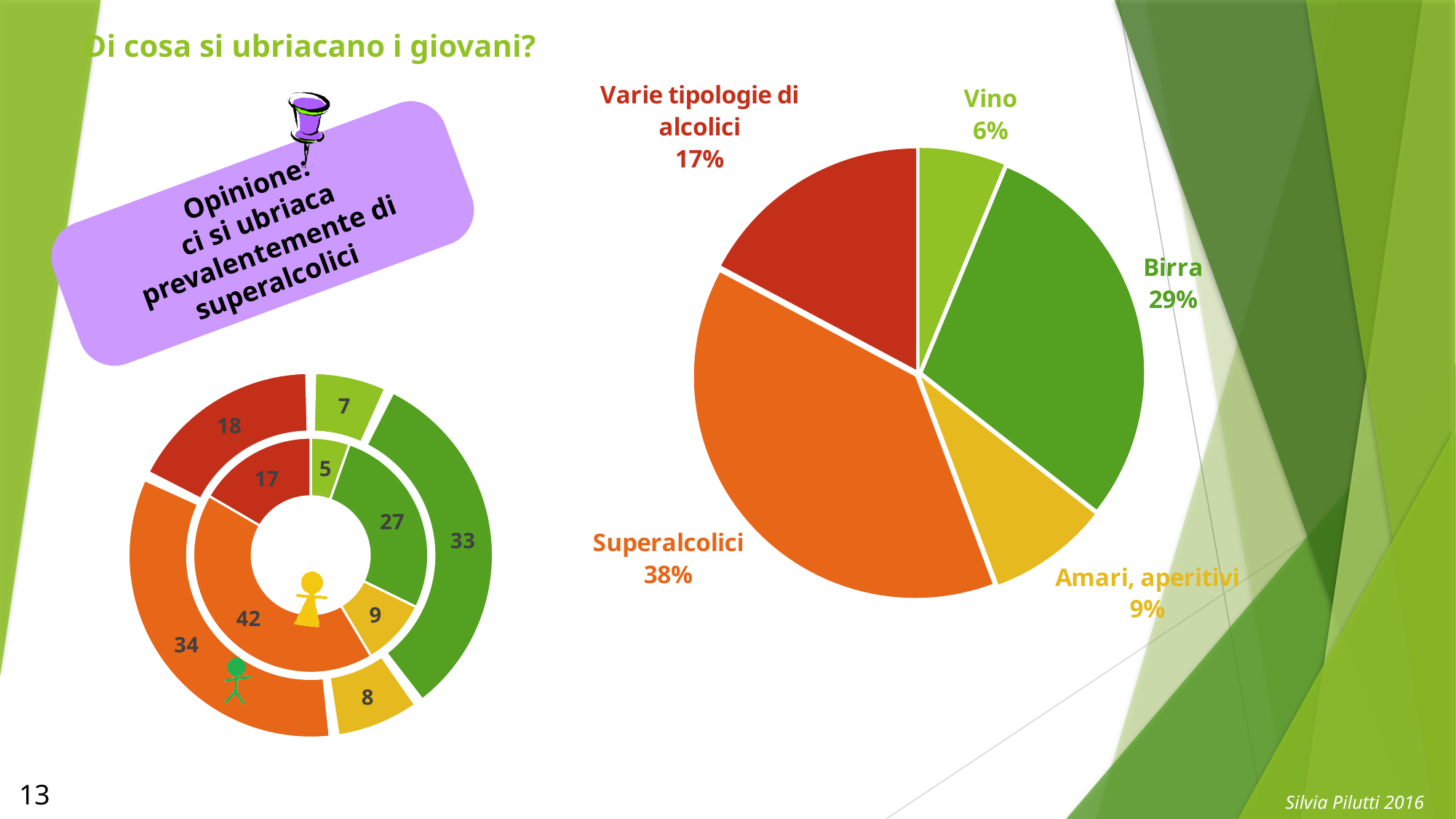
In the pie chart on the right, what share is shown for Superalcolici? 38% In the doughnut chart on the lower left, what is the largest value labelled in the inner ring? 42 In the pie chart on the right, what is the difference between the shares of Birra and Vino? 23% In the pie chart on the right, what share is shown for Birra? 29% In the pie chart on the right, which category has the largest slice? Superalcolici In the pie chart on the right, which is larger: Birra or Varie tipologie di alcolici? Birra In the doughnut chart on the lower left, what value is labelled on the orange segment of the outer ring? 34 In the pie chart on the right, which category has the smallest slice? Vino In the pie chart on the right, what share is shown for Amari, aperitivi? 9% What kind of chart is the chart on the right of the slide? Pie chart What kind of chart is the chart on the lower left of the slide? Doughnut chart In the pie chart on the right, how many slices are there? 5